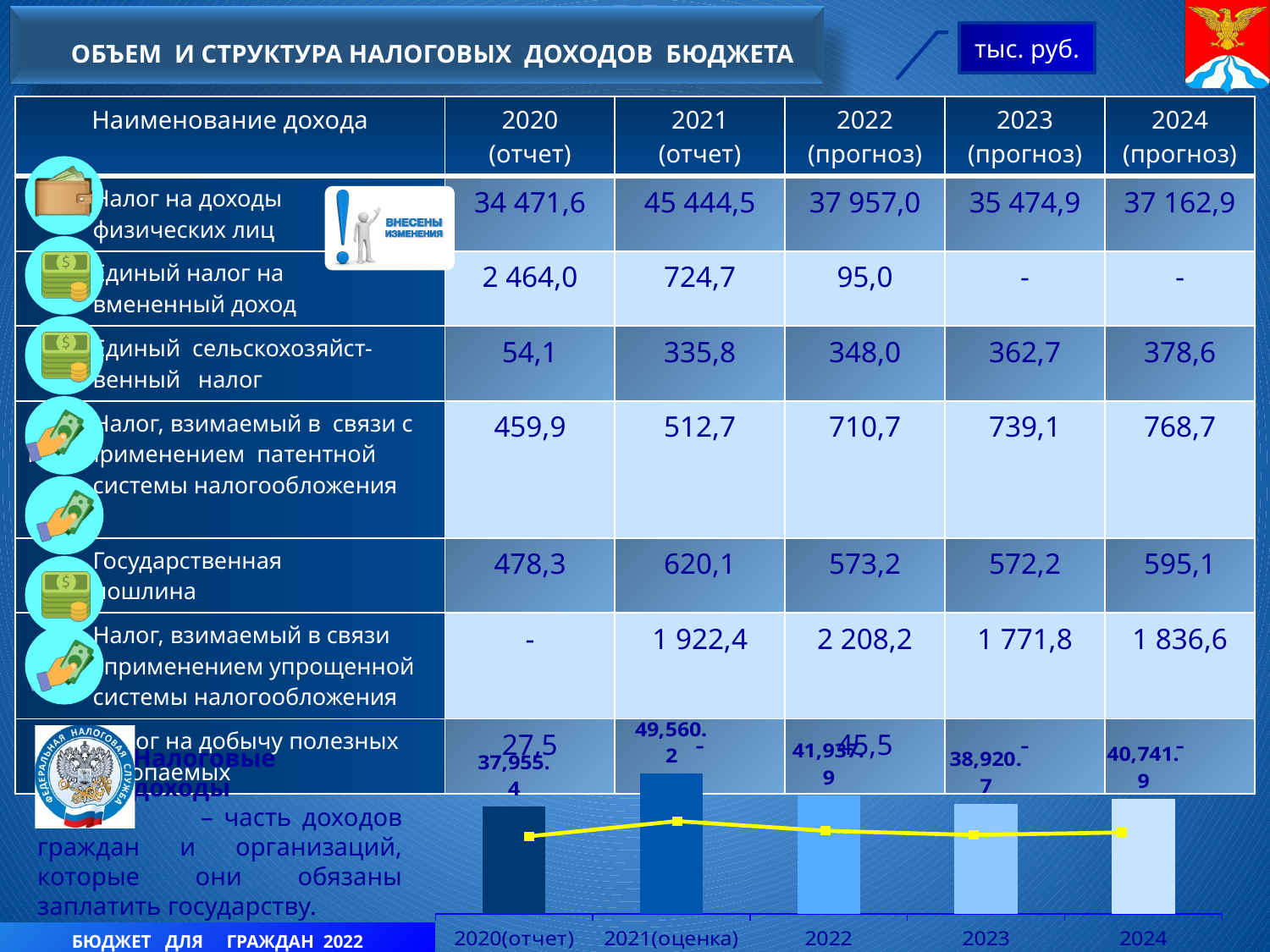
In the chart at the bottom of the slide, which year has the highest value? 2021(оценка) In the chart at the bottom of the slide, what is the value labelled for 2023? 38,920.7 In the chart at the bottom of the slide, what is the value labelled for 2024? 40,741.9 How many years (categories) are plotted on the x axis of the chart at the bottom of the slide? 5 In the chart at the bottom of the slide, what is the value labelled for 2020(отчет)? 37,955.4 In the chart at the bottom of the slide, what is the value labelled for 2021(оценка)? 49,560.2 What type of chart is shown at the bottom of the slide? bar chart with a line What is the x-axis label of the first category in the chart at the bottom of the slide? 2020(отчет) In the chart at the bottom of the slide, do the values rise or fall from 2021(оценка) to 2023? fall In the chart at the bottom of the slide, which year has the lowest value? 2020(отчет) In the chart at the bottom of the slide, which is larger: the value for 2022 or the value for 2023? 2022 In the chart at the bottom of the slide, what is the difference between the values for 2021(оценка) and 2020(отчет)? 11,604.8